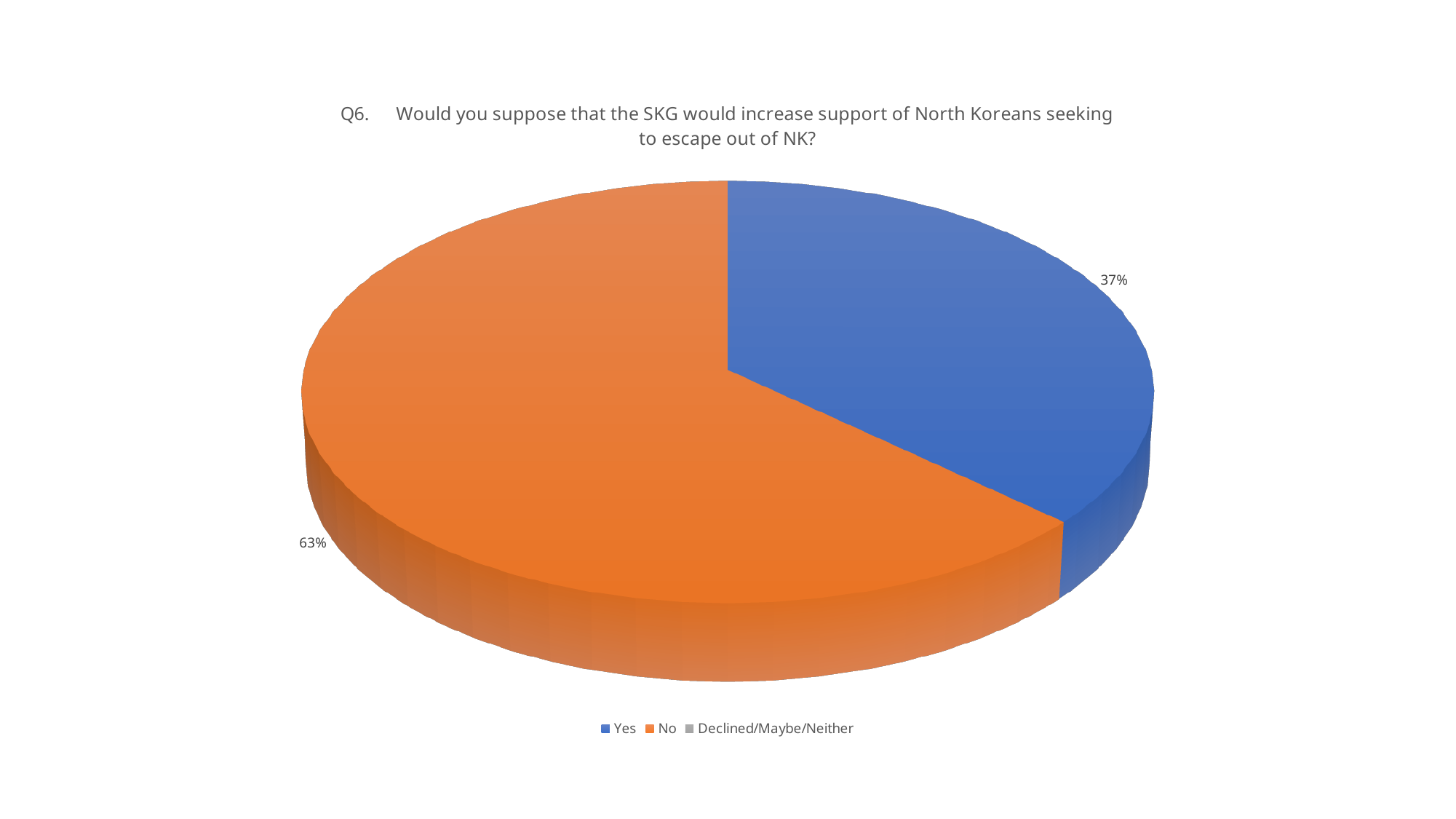
Is the share for "Yes" greater or less than 50%? less What colour is the "No" slice? Orange Which of the two visible slices is larger, "Yes" or "No"? No Is the share for "No" greater or less than 50%? greater Which response has the largest share of the pie? No How many entries does the legend list? 3 What kind of chart is shown on the slide? Pie chart What share of the pie does the "Yes" slice represent? 37% What is the question number shown at the start of the chart title? Q6 Which legend entry is shown in blue? Yes What share of the pie does the "No" slice represent? 63% What is the difference in percentage points between the "No" share and the "Yes" share? 26